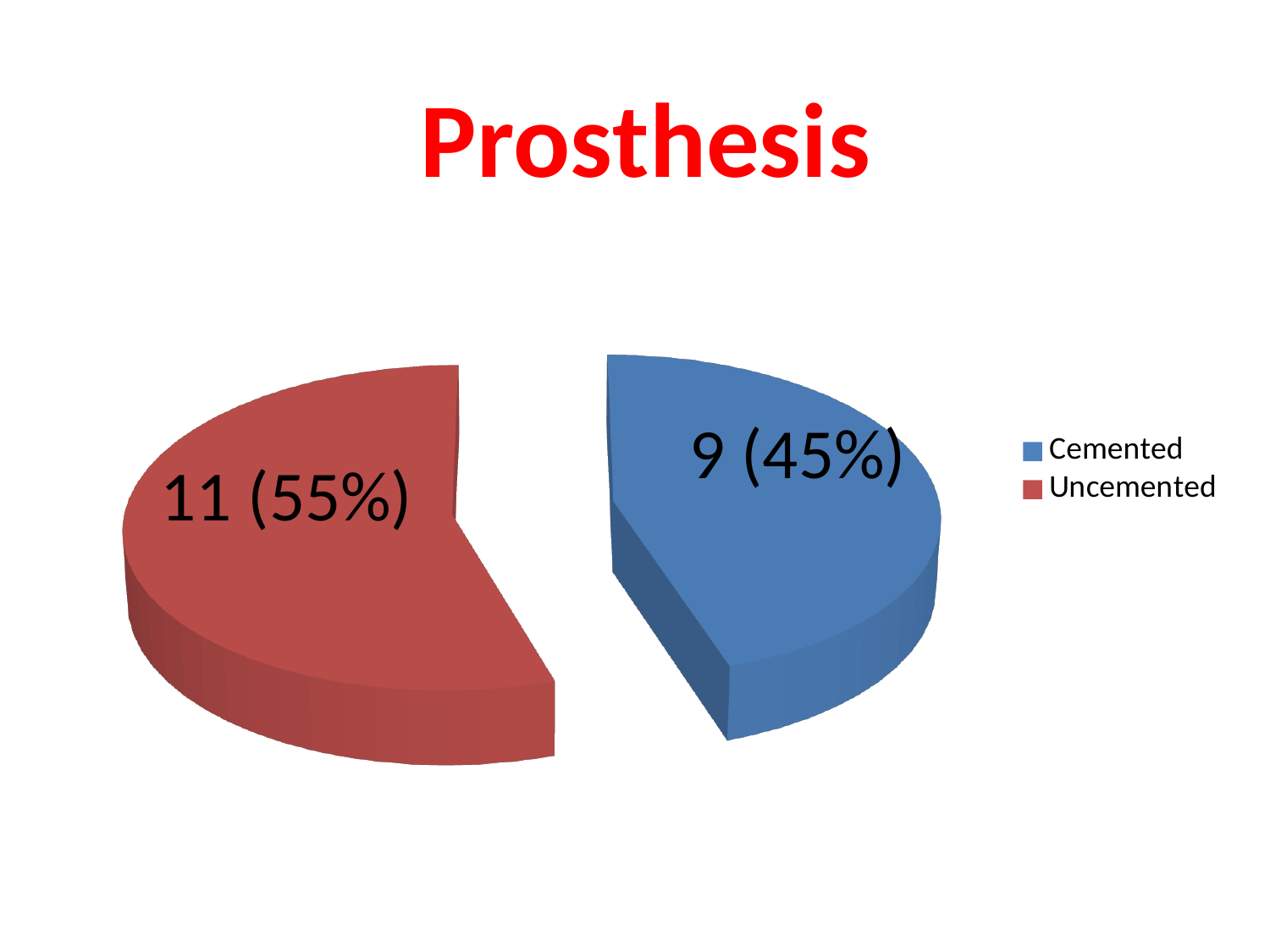
How many entries does the legend list? 2 What share of the pie is Uncemented? 55% Which colour represents Cemented in the chart? blue How many slices does the pie chart have? 2 Which category has the largest slice? Uncemented What is the count for Uncemented? 11 Which category has the smallest slice? Cemented What is the difference in count between Uncemented and Cemented? 2 What is the title of the chart? Prosthesis What kind of chart is shown on the slide? pie chart What is the count for Cemented? 9 What share of the pie is Cemented? 45%